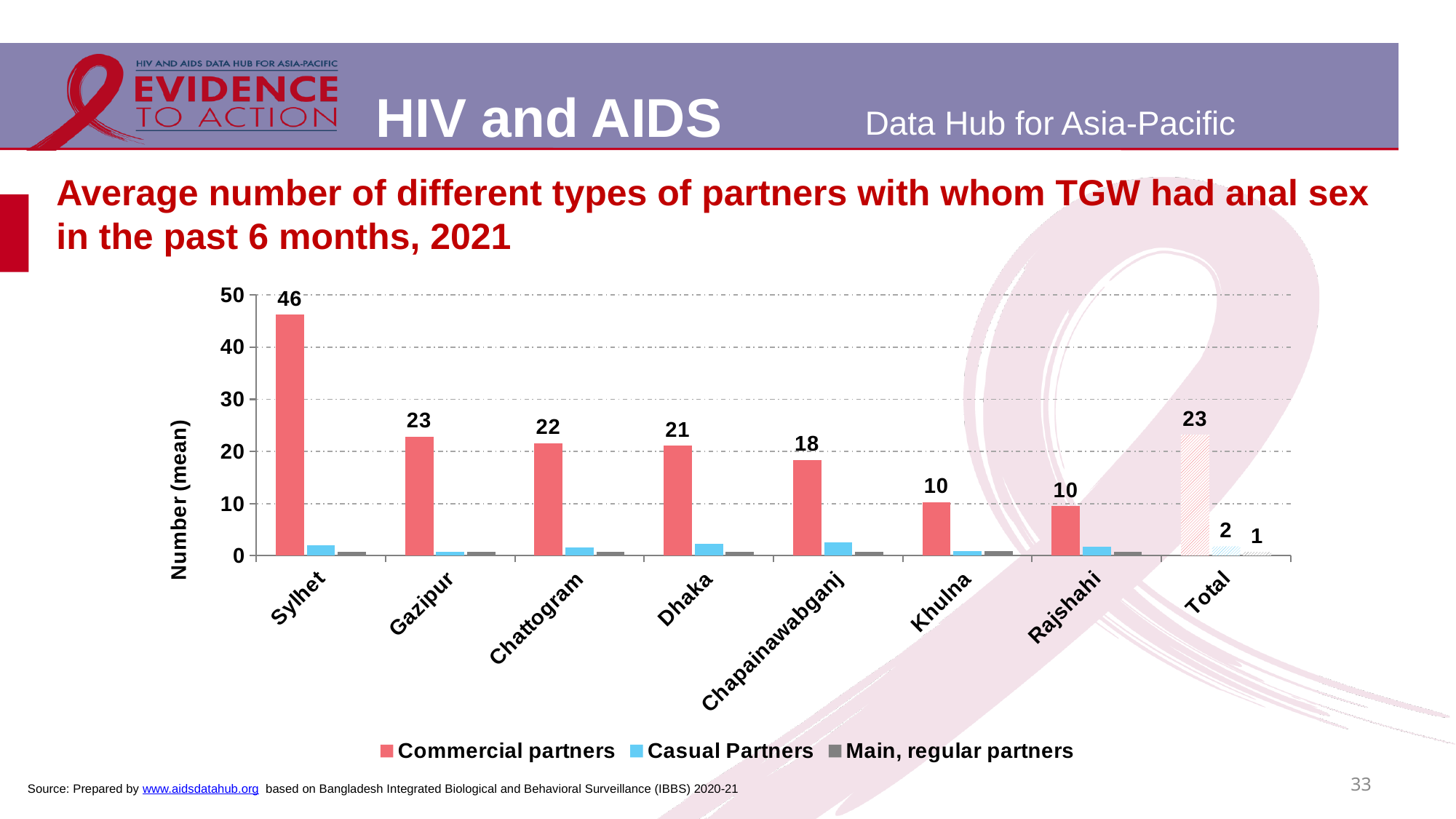
Which has a larger Commercial partners value, Chattogram or Dhaka? Chattogram What is the title of the y axis? Number (mean) Which category has the highest value for Commercial partners? Sylhet What kind of chart is shown on the slide? bar chart What is the value for Commercial partners in Chapainawabganj? 18 What is the value for Commercial partners in Sylhet? 46 What is the difference between the Commercial partners values for Sylhet and Gazipur? 23 What is the value for Main, regular partners in the Total category? 1 What is the value for Casual Partners in the Total category? 2 How many categories are shown on the x axis? 8 How many series does the legend list? 3 Is the value for Casual Partners in Sylhet greater or less than 10? less